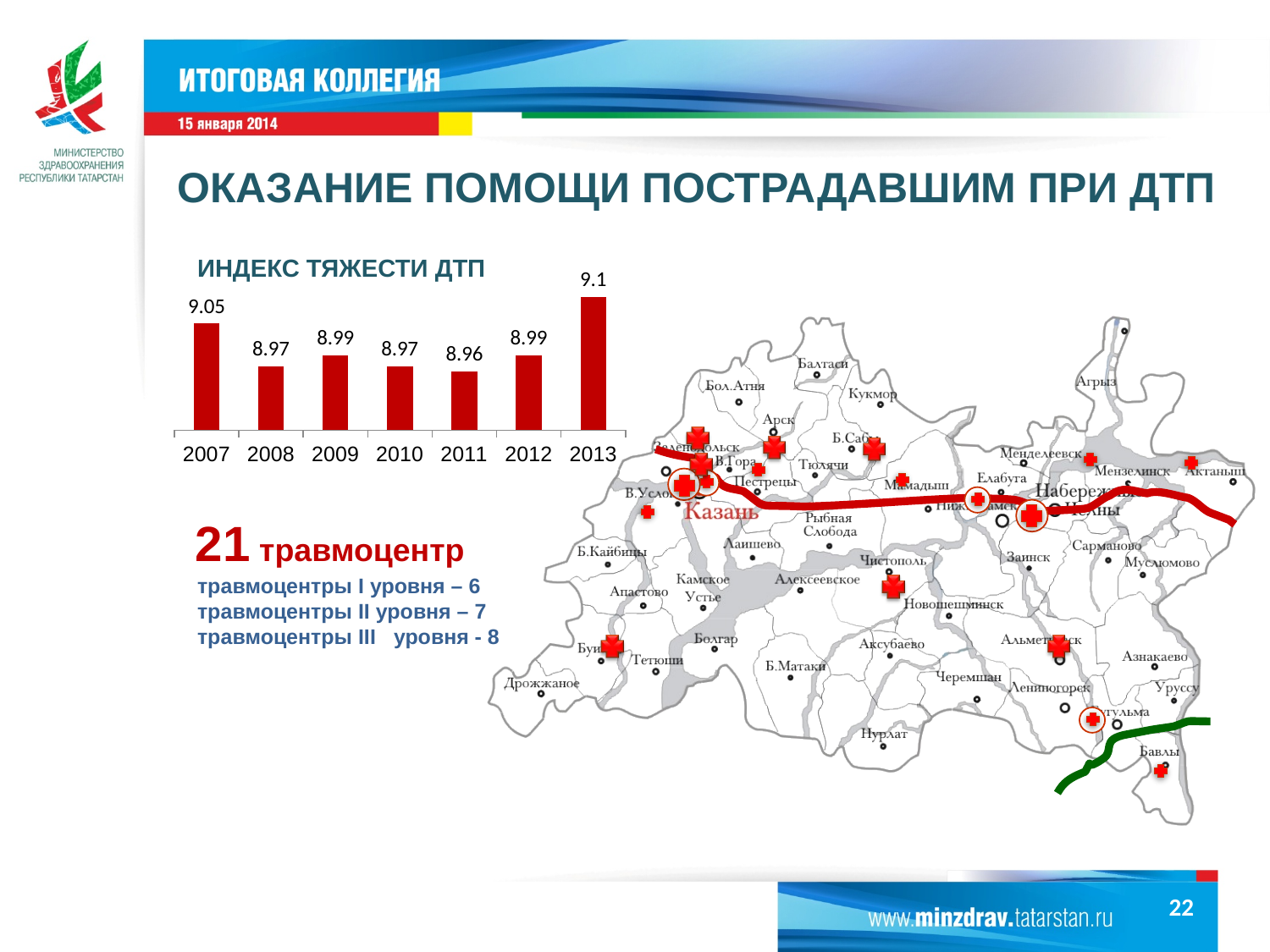
What is the value of the ДТП severity index for 2013? 9.1 What is the title of the chart on the slide? ИНДЕКС ТЯЖЕСТИ ДТП What is the value of the ДТП severity index for 2011? 8.96 What is the value of the ДТП severity index for 2007? 9.05 Which year has the highest ДТП severity index? 2013 Which year has the lowest ДТП severity index? 2011 What is the difference between the ДТП severity index in 2013 and in 2007? 0.05 What is the value of the ДТП severity index for 2010? 8.97 What kind of chart is used to show the ДТП severity index? Bar chart How many years are shown in the ДТП severity index chart? 7 Which year has a higher ДТП severity index, 2009 or 2008? 2009 What is the difference between the ДТП severity index in 2007 and in 2011? 0.09